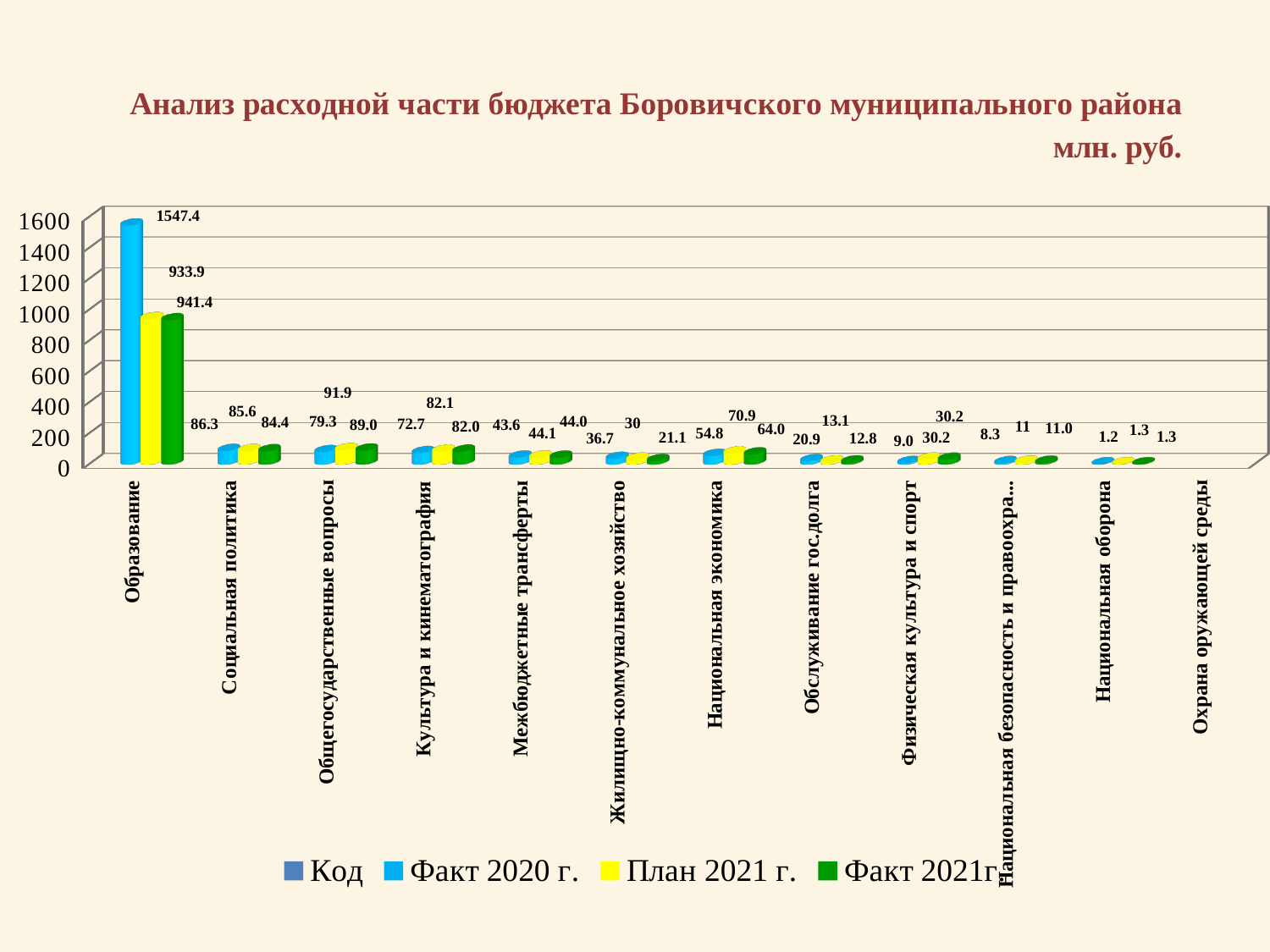
What is the Факт 2020 г. value for Образование? 1547.4 What kind of chart is shown on the slide? Bar chart What is the План 2021 г. value for Национальная экономика? 70.9 How many categories are shown on the x axis? 12 What is the difference between the План 2021 г. and Факт 2021г. values for Национальная экономика? 6.9 What is the Факт 2021г. value for Физическая культура и спорт? 30.2 What is the difference between the Факт 2020 г. and План 2021 г. values for Образование? 606.0 For Обслуживание гос.долга, which is larger: the Факт 2020 г. value or the Факт 2021г. value? Факт 2020 г. How many series does the legend list? 4 Which category has the highest Факт 2020 г. value? Образование What unit is stated in the chart title? млн. руб. What is the Факт 2021г. value for Жилищно-коммунальное хозяйство? 21.1